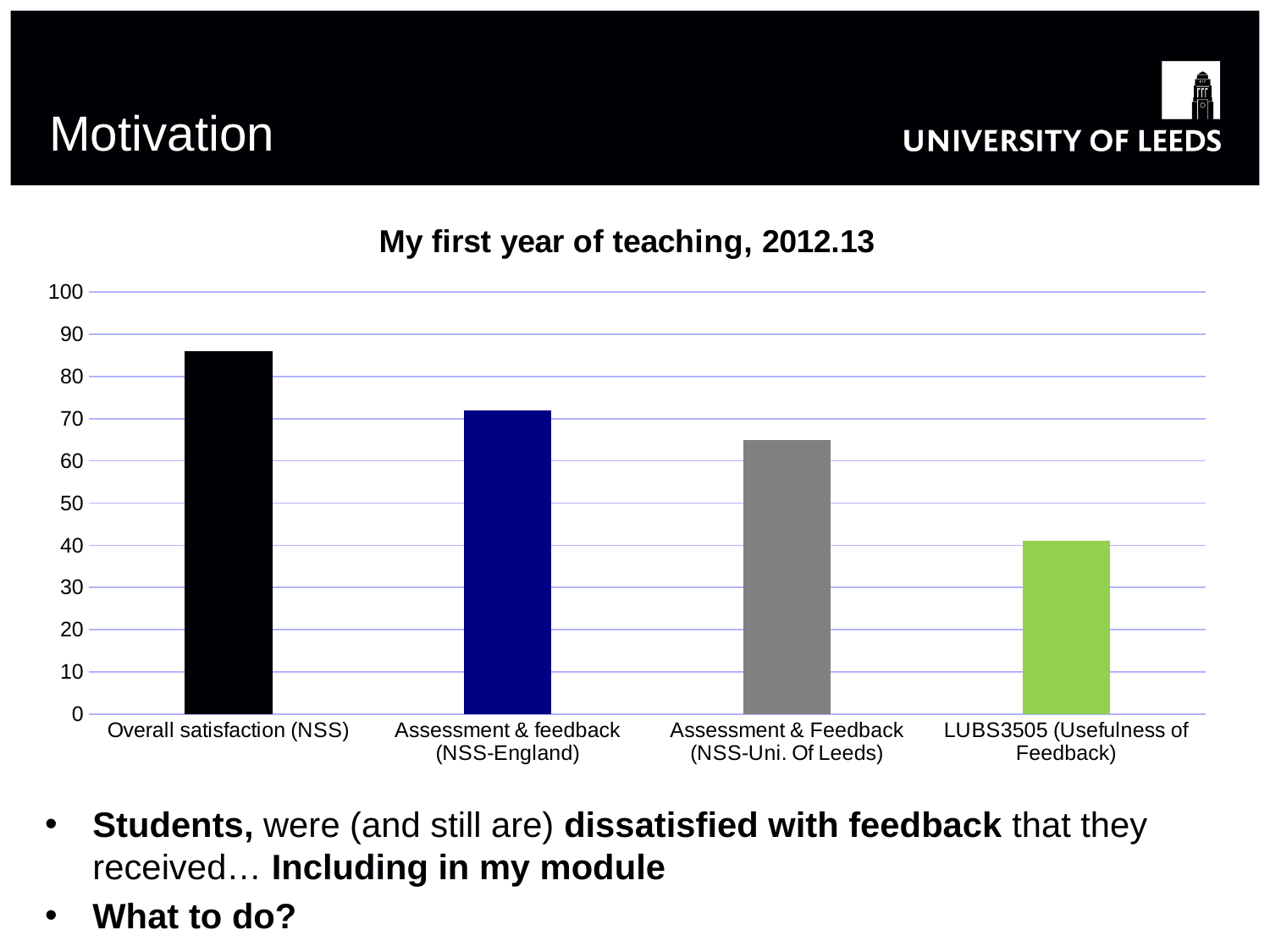
How many categories are plotted in the chart? 4 What is the title of the chart? My first year of teaching, 2012.13 Which is larger: Assessment & feedback (NSS-England) or Assessment & Feedback (NSS-Uni. Of Leeds)? Assessment & feedback (NSS-England) What type of chart is shown on the slide? bar chart What colour is the bar for LUBS3505 (Usefulness of Feedback)? green Which category has the lowest value? LUBS3505 (Usefulness of Feedback) Do the values rise or fall from left to right across the categories? fall Is the value for Assessment & feedback (NSS-England) greater or less than 60? greater Is the value for Overall satisfaction (NSS) greater or less than 80? greater Is the value for Assessment & Feedback (NSS-Uni. Of Leeds) greater or less than 70? less Which category has the highest value? Overall satisfaction (NSS)